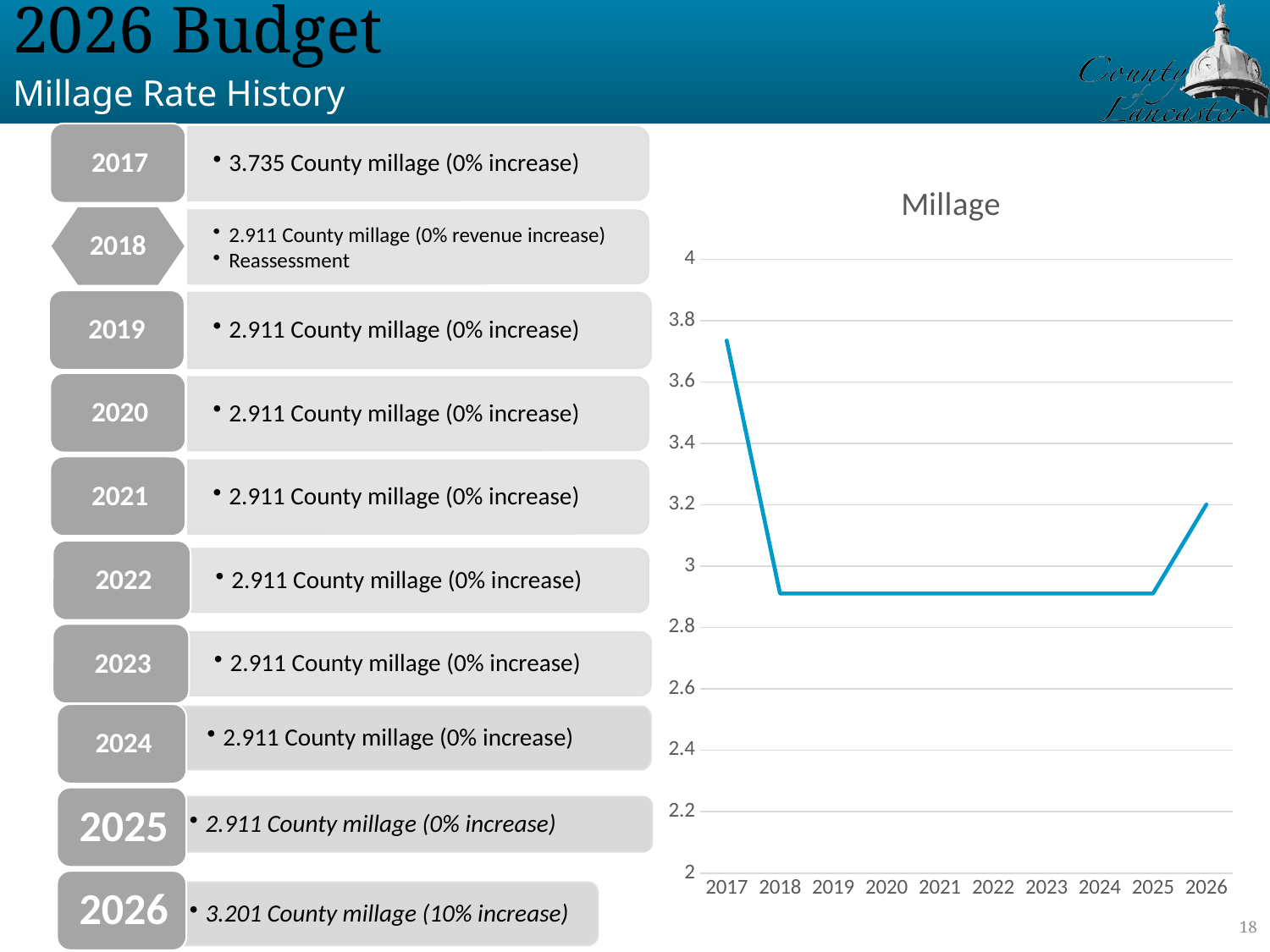
According to the slide, what was the County millage in 2017? 3.735 What is the title of the chart? Millage Does the millage value rise or fall from 2025 to 2026? rise Which year has the highest millage value in the chart? 2017 Is the millage value for 2020 greater or less than 3? less Which year has the larger millage value, 2017 or 2026? 2017 According to the slide, what was the County millage in 2026? 3.201 How many years are plotted along the x axis of the Millage chart? 10 Is the millage value for 2017 greater or less than 3.6? greater Does the millage value rise or fall from 2017 to 2018? fall Is the millage value for 2026 greater or less than 3? greater What type of chart is shown on the slide? line chart